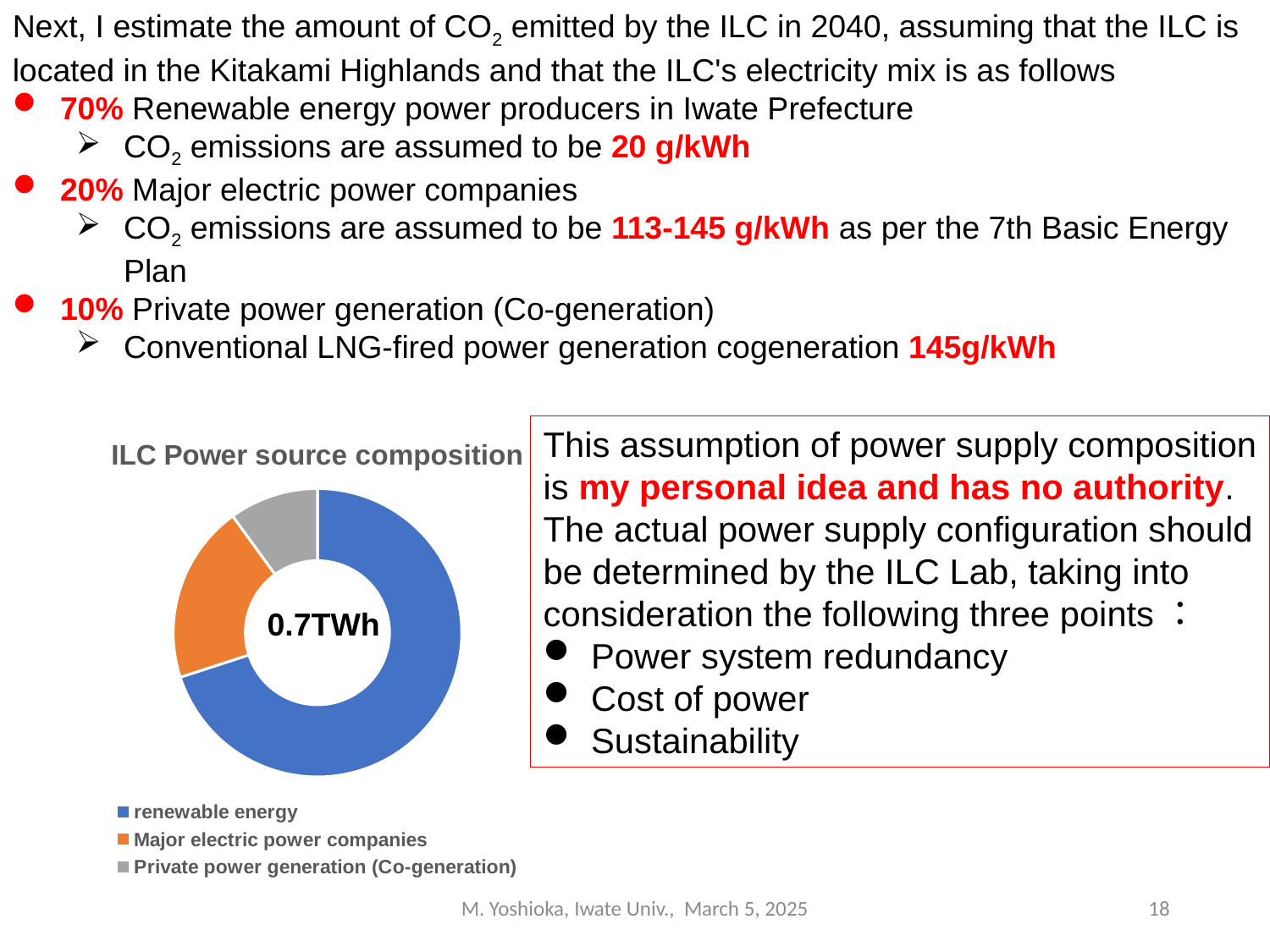
What colour represents renewable energy in the ILC Power source composition chart? blue What value is printed in the centre of the ILC Power source composition chart? 0.7TWh In the ILC Power source composition chart, which slice is larger: renewable energy or Major electric power companies? renewable energy Which category has the largest slice in the ILC Power source composition chart? renewable energy How many entries does the legend of the ILC Power source composition chart list? 3 Which category has the smallest slice in the ILC Power source composition chart? Private power generation (Co-generation) What share of the ILC Power source composition is Major electric power companies? 20% How many slices does the ILC Power source composition chart have? 3 What kind of chart is shown under the title "ILC Power source composition"? pie chart (doughnut) In the ILC Power source composition chart, which slice is larger: Major electric power companies or Private power generation (Co-generation)? Major electric power companies What share of the ILC Power source composition is Private power generation (Co-generation)? 10% What share of the ILC Power source composition is renewable energy? 70%